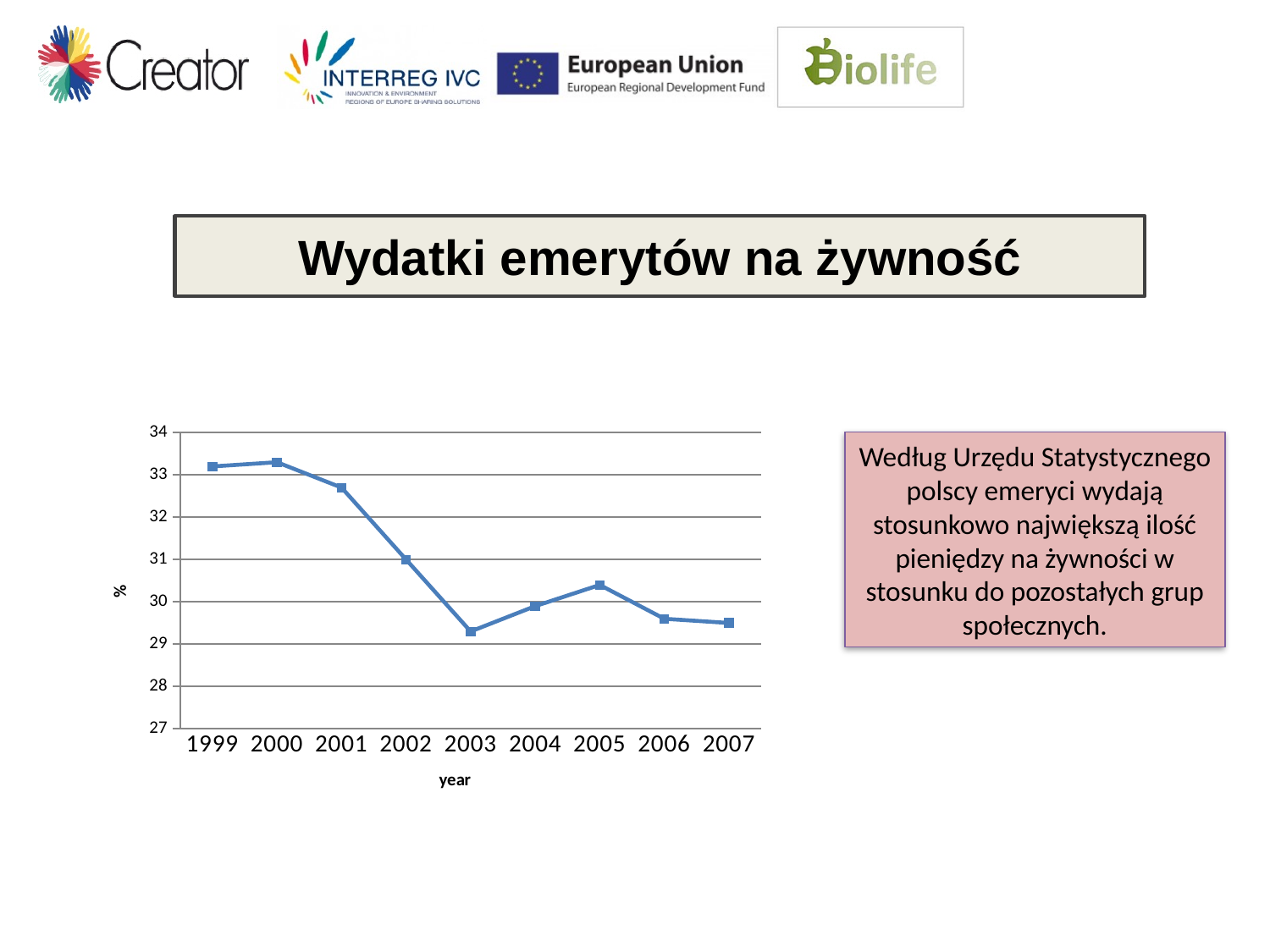
What is the label on the x axis of the chart? year Which year has the larger value, 2005 or 2006? 2005 What is the label on the y axis of the chart? % Overall, do the values rise or fall from 1999 to 2007? fall How many years are plotted on the x axis of the chart? 9 What kind of chart is shown on the slide? line chart Is the value for 1999 greater or less than 33? greater Is the value for 2003 greater or less than 30? less Is the value for 2001 greater or less than 32? greater Which year has the larger value, 1999 or 2003? 1999